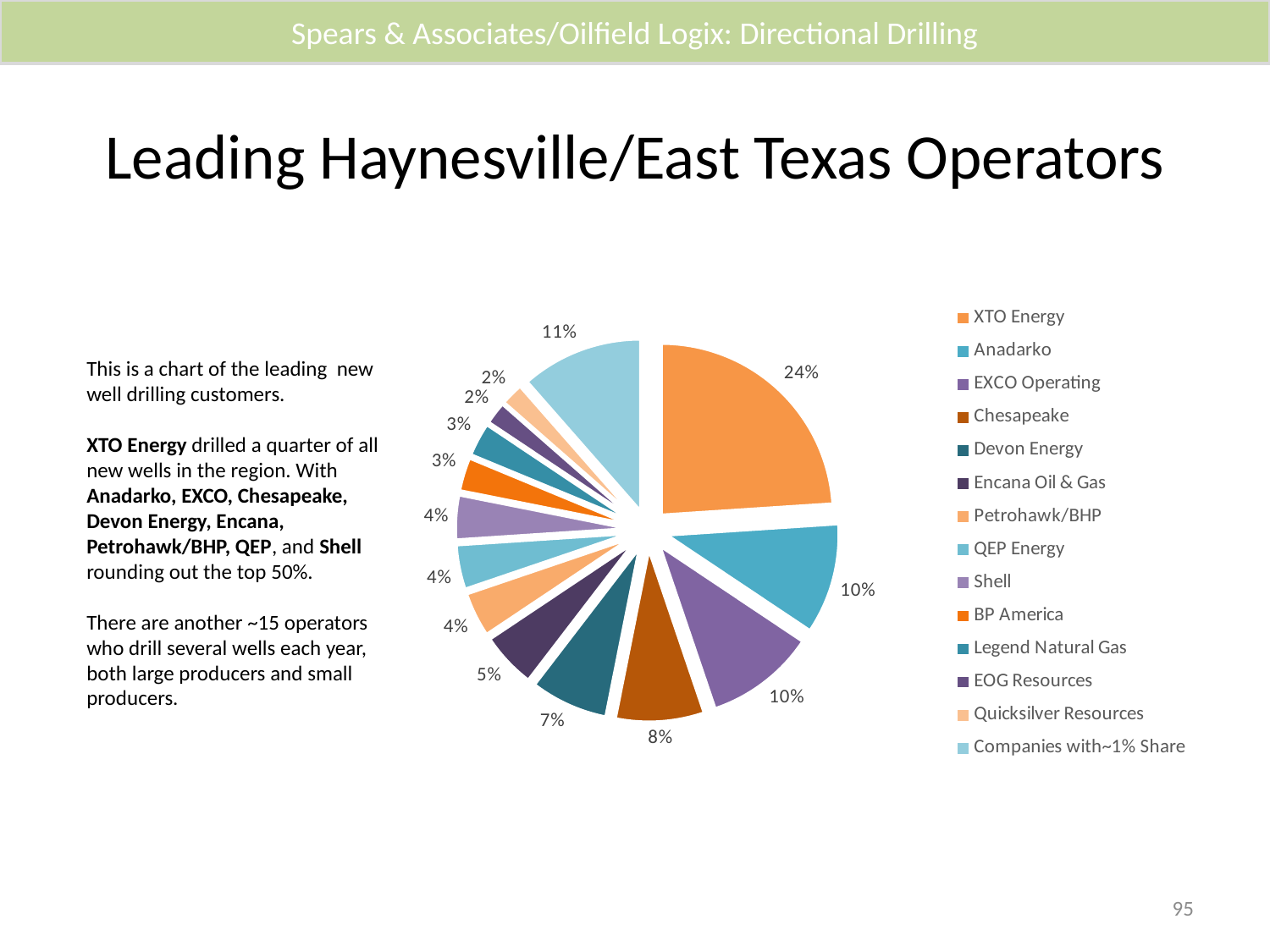
What share of the pie does Encana Oil & Gas hold? 5% Which has the larger share, Chesapeake or Devon Energy? Chesapeake What share of the pie does Devon Energy hold? 7% What share of the pie does XTO Energy hold? 24% What share of the pie is labelled for Companies with ~1% Share? 11% What kind of chart is shown on the slide? pie chart What share of the pie does Chesapeake hold? 8% What share of the pie does EOG Resources hold? 2% What is the combined share of Anadarko and EXCO Operating? 20% Which operator has the largest slice of the pie? XTO Energy What is the difference between XTO Energy's share and Anadarko's share? 14% How many entries does the legend list? 14